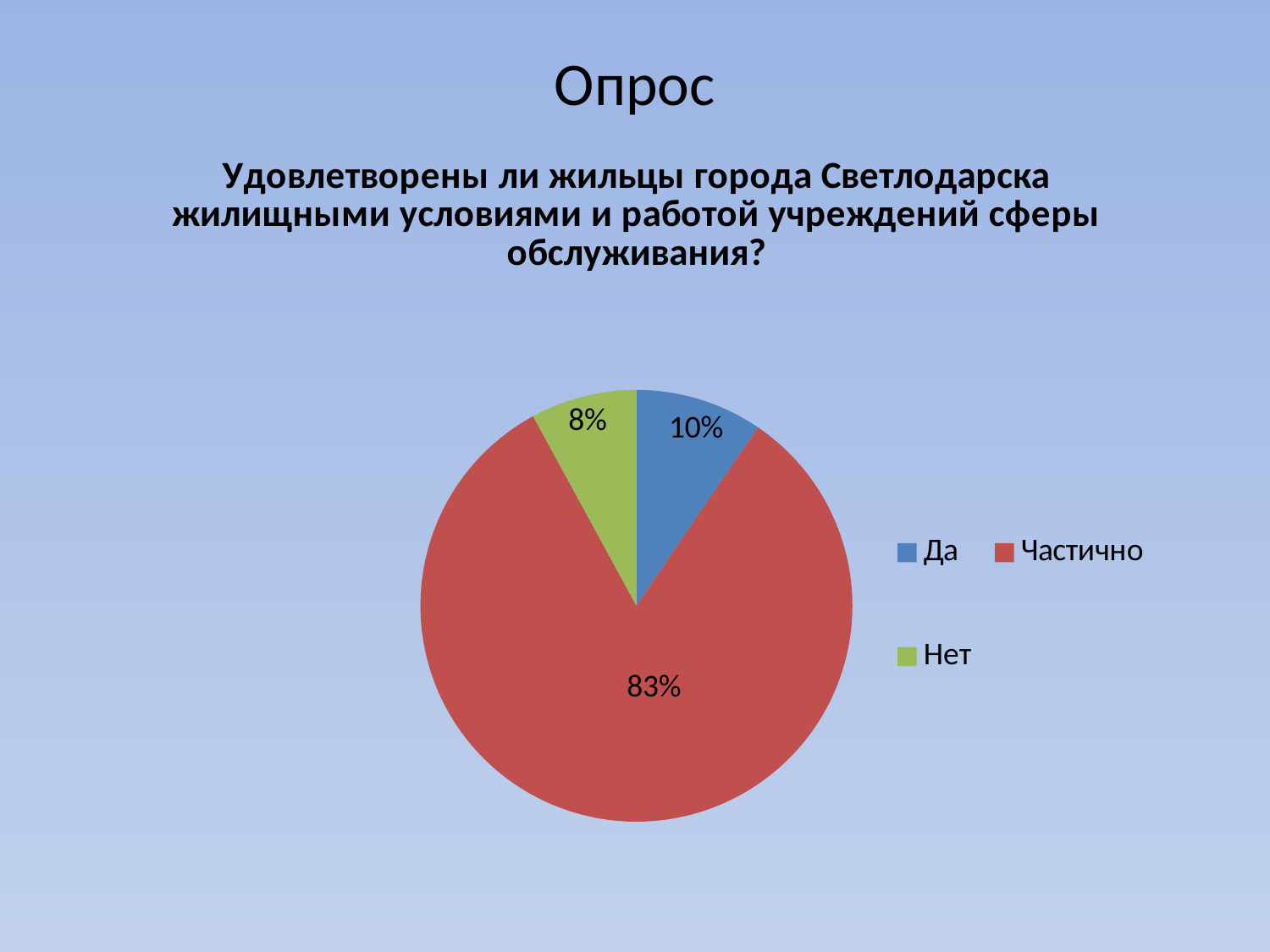
What share of the pie does "Да" have? 10% How many categories does the pie chart show? 3 Which category has the smallest slice of the pie? Нет Which is larger, the slice for "Частично" or the slice for "Нет"? Частично What is the difference in percentage points between "Частично" and "Да"? 73 How many entries does the legend list? 3 Which category has the largest slice of the pie? Частично What kind of chart is shown on the slide? pie chart What share of the pie does "Нет" have? 8% What share of the pie does "Частично" have? 83% What colour is the slice for "Частично"? red What is the difference in percentage points between "Да" and "Нет"? 2